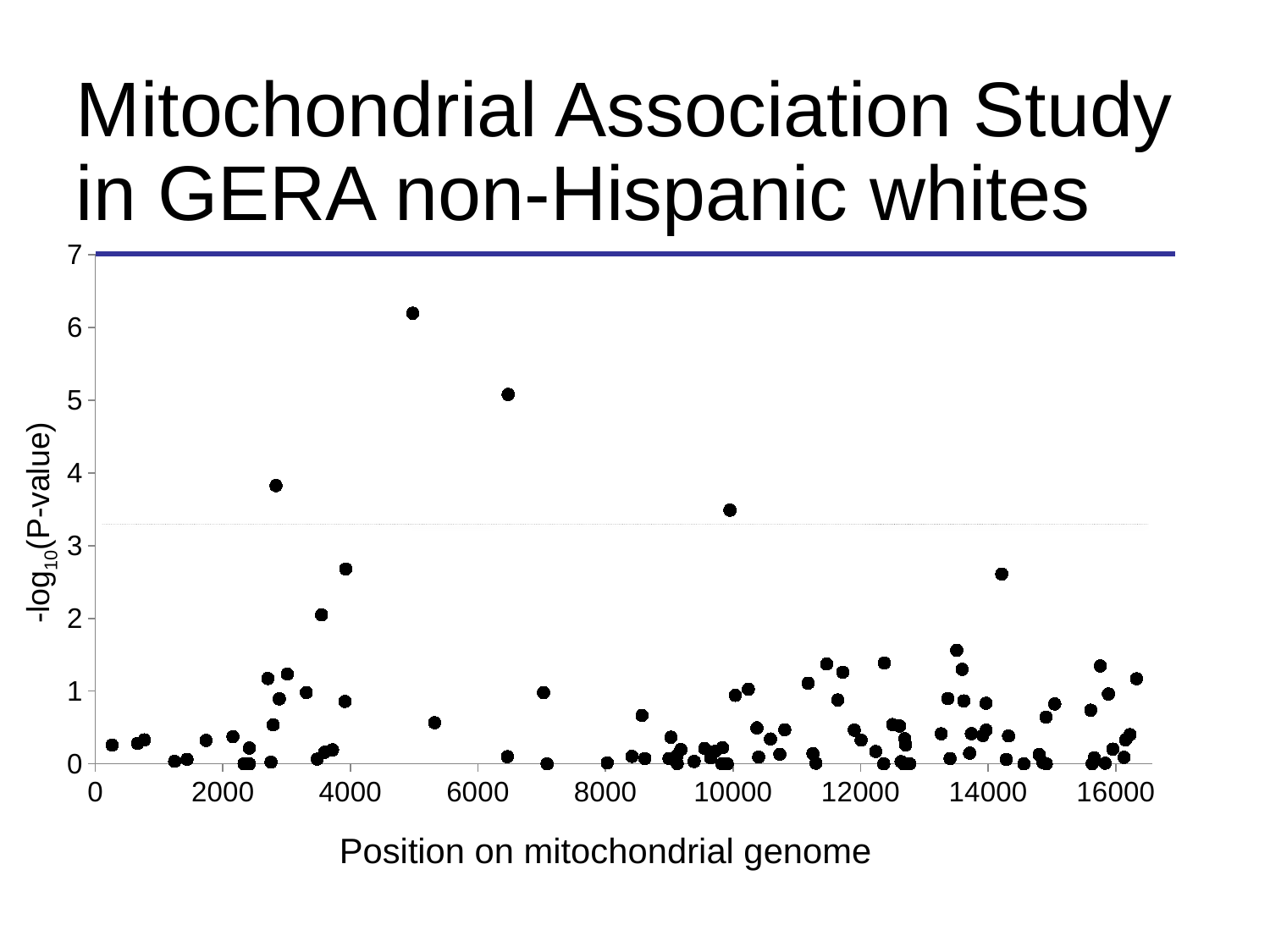
Is the point near x = 10000 that rises above the dotted line greater or less than 3 on the y axis? greater How many points lie above 4 on the y axis? 2 Is the highest point on the chart greater or less than 7 on the y axis? less What is the title of the chart on the slide? Mitochondrial Association Study in GERA non-Hispanic whites What kind of chart is shown on the slide? scatter plot Is the second-highest point (near x = 6500) greater or less than 4 on the y axis? greater Is the highest point located between the 4000 and 6000 ticks on the x axis? yes What is the maximum tick value shown on the y axis? 7 How many points lie above 3 on the y axis? 4 What is the largest tick value shown on the x axis? 16000 What is the label of the x axis? Position on mitochondrial genome